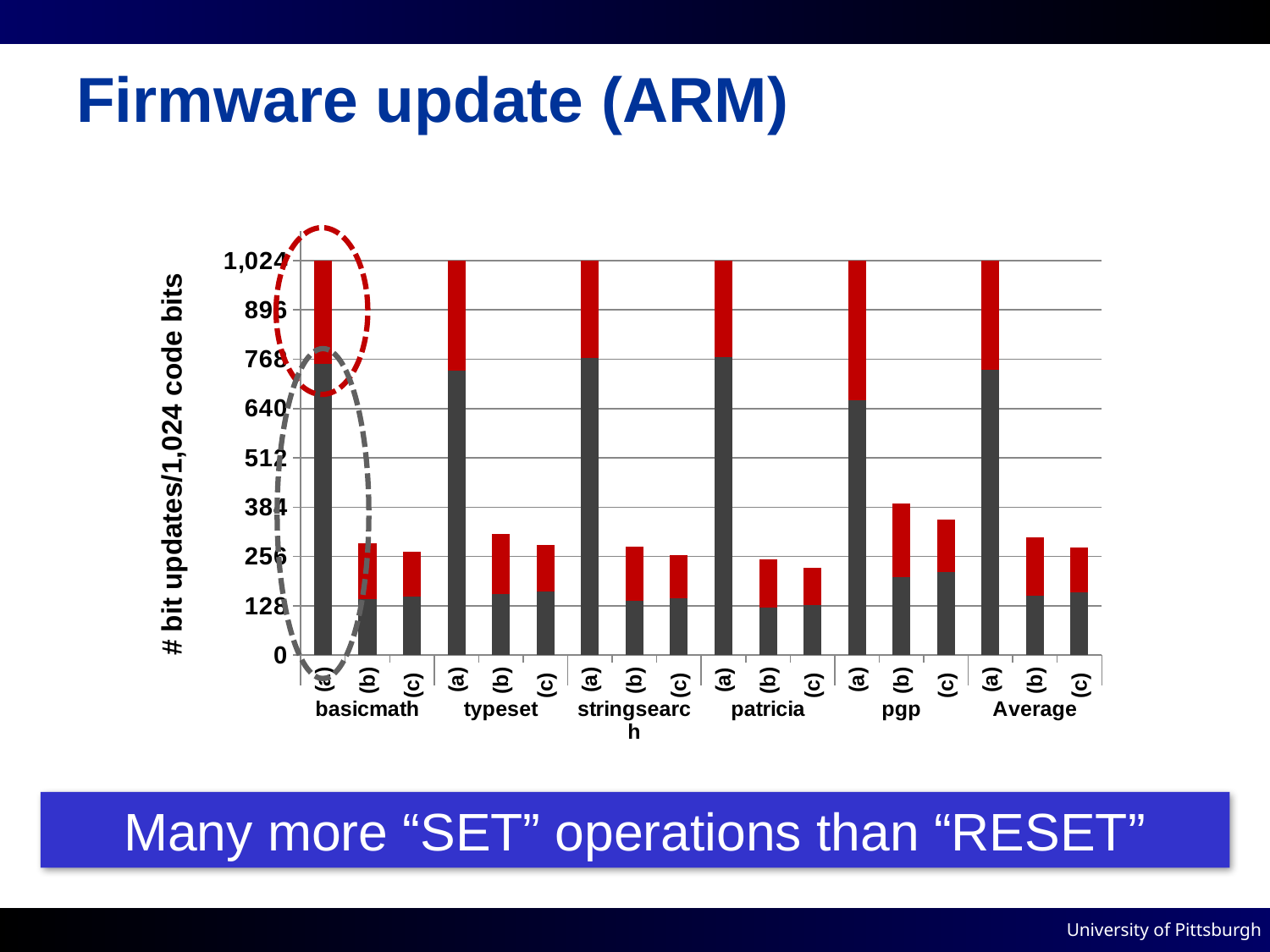
How many bars are plotted in the chart in total? 18 Within the basicmath group, which bar is taller, (a) or (b)? (a) Is the total value for typeset (b) greater or less than 256? greater Is the total value for patricia (c) greater or less than 256? less What is the y-axis title of the chart? # bit updates/1,024 code bits Among the (b) bars, which benchmark group has the tallest bar? pgp Is the total value for pgp (b) greater or less than 256? greater What is the total height of the basicmath (a) bar? 1,024 How many benchmark groups are labelled along the x axis of the chart? 6 Which is taller, the pgp (b) bar or the typeset (b) bar? pgp (b) What kind of chart is shown on the slide? stacked bar chart What is the highest value shown on the y axis of the chart? 1,024